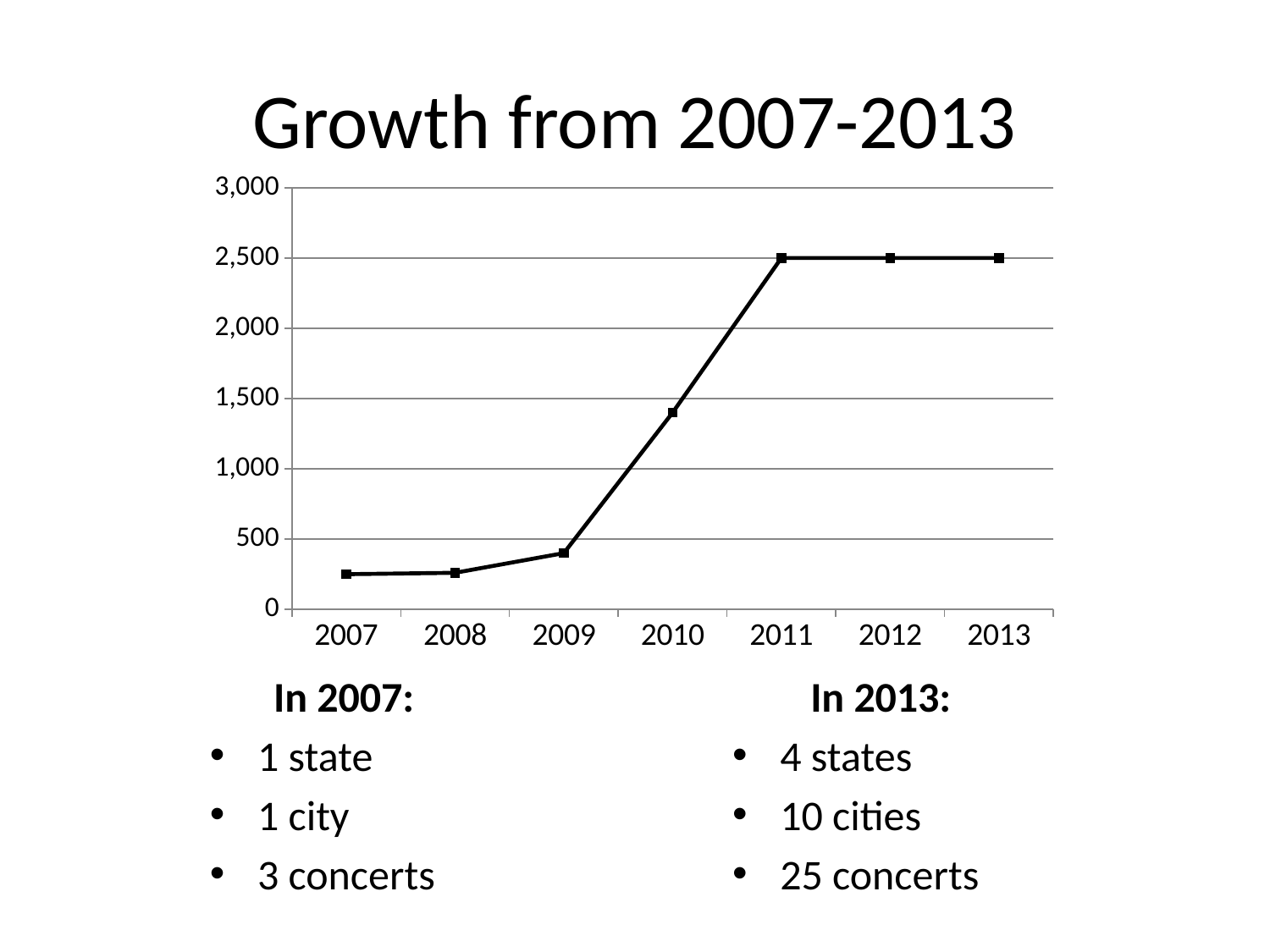
What is the title of the chart? Growth from 2007-2013 Do the values generally rise or fall from 2007 to 2013? rise How many years are plotted on the x axis of the chart? 7 What is the value for 2013? 2,500 Is the value for 2009 greater or less than 500? less Which year has the larger value, 2010 or 2011? 2011 Is the value for 2010 greater or less than 1,000? greater Is the value for 2010 greater or less than 1,500? less What kind of chart is shown on the slide? line chart What is the value for 2011? 2,500 Which year has the larger value, 2009 or 2010? 2010